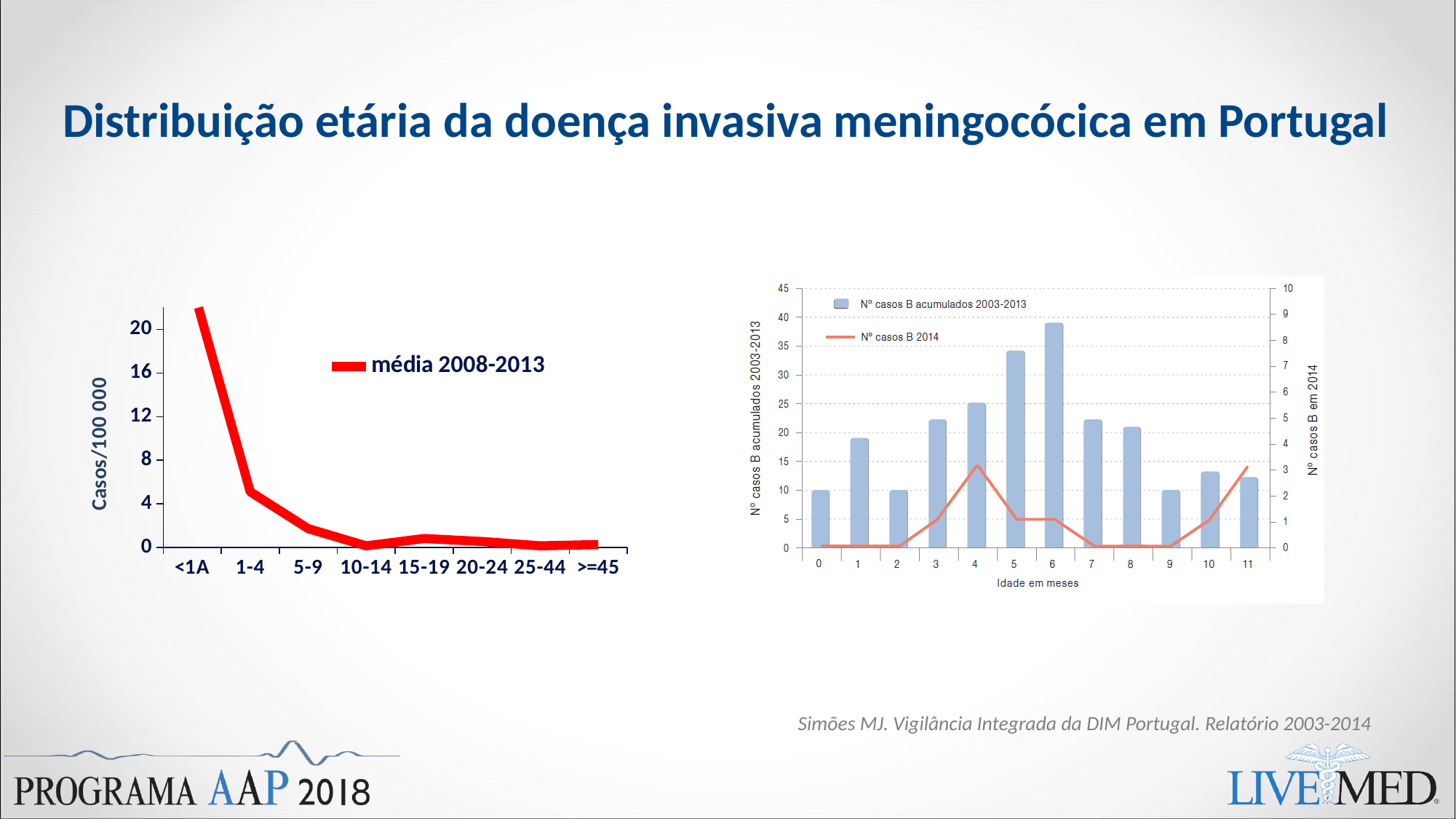
In the left chart (média 2008-2013), is the value for 5-9 greater or less than 4? less In the right chart (Idade em meses), how many months are shown on the x axis? 12 In the right chart (Idade em meses), is the Nº casos B acumulados 2003-2013 value for month 6 greater or less than 35? greater In the left chart (média 2008-2013), which age group has the highest value? <1A In the right chart (Idade em meses), is the Nº casos B acumulados 2003-2013 value for month 5 greater or less than 30? greater In the right chart (Idade em meses), which month has the highest number of Nº casos B acumulados 2003-2013? 6 How many series does the legend of the right chart (Idade em meses) list? 2 What kind of chart is the left chart (média 2008-2013)? line chart How many age groups are shown on the x axis of the left chart (média 2008-2013)? 8 In the left chart (média 2008-2013), do the values generally rise or fall from <1A to >=45? fall What is the y-axis label of the left chart (média 2008-2013)? Casos/100 000